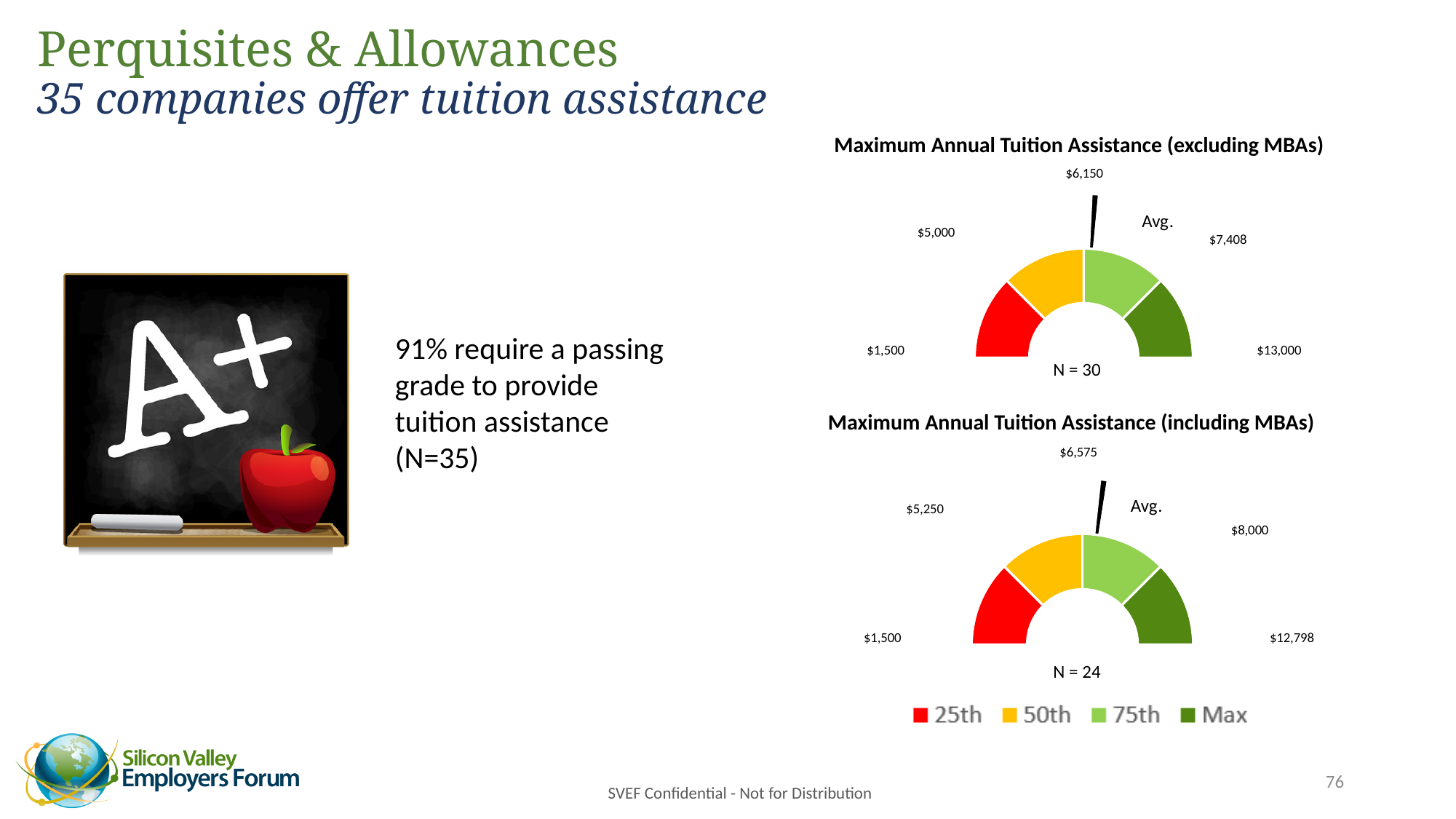
In the 'Maximum Annual Tuition Assistance (including MBAs)' chart, what is the highest value labeled on the gauge? $12,798 Which chart shows a higher average value, 'excluding MBAs' or 'including MBAs'? including MBAs What is the difference between the maximum values in the 'excluding MBAs' chart ($13,000) and the 'including MBAs' chart ($12,798)? $202 In the 'Maximum Annual Tuition Assistance (including MBAs)' chart, what is the average value shown by the needle? $6,575 In the 'Maximum Annual Tuition Assistance (excluding MBAs)' chart, what is the average value shown by the needle? $6,150 What is the sample size (N) shown for the 'Maximum Annual Tuition Assistance (including MBAs)' chart? N = 24 What is the difference between the average values in the 'including MBAs' chart and the 'excluding MBAs' chart? $425 In the 'Maximum Annual Tuition Assistance (including MBAs)' chart, what is the lowest value labeled on the gauge? $1,500 In the legend below the charts, which colour represents the 25th percentile? Red How many entries does the shared legend below the charts list? 4 What kind of chart is used for 'Maximum Annual Tuition Assistance (excluding MBAs)'? Gauge chart In the 'Maximum Annual Tuition Assistance (excluding MBAs)' chart, what is the highest value labeled on the gauge? $13,000